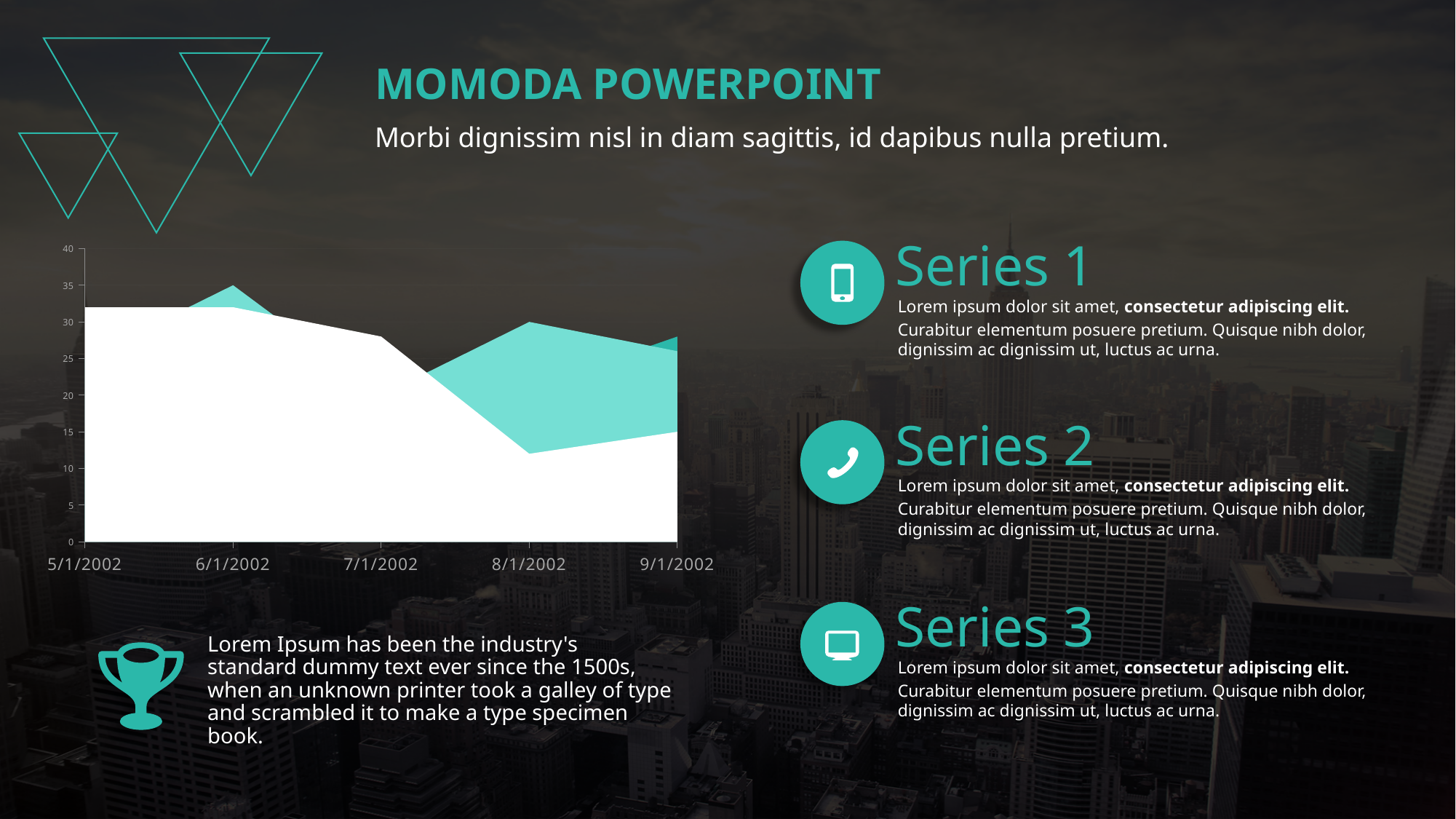
Is the value of the white area at 5/1/2002 greater or less than 30? greater What is the first date labelled on the chart's x axis? 5/1/2002 At which date does the white area reach its lowest value? 8/1/2002 What kind of chart is shown on the slide? area chart Is the value of the teal area at 6/1/2002 greater or less than 30? greater At which date does the teal area reach its highest value? 6/1/2002 Is the value of the white area at 8/1/2002 greater or less than 15? less At 8/1/2002, which is larger: the teal area or the white area? the teal area Does the white area rise or fall from 5/1/2002 to 8/1/2002? fall How many dates are labelled along the x axis of the chart? 5 What is the highest value shown on the chart's y axis? 40